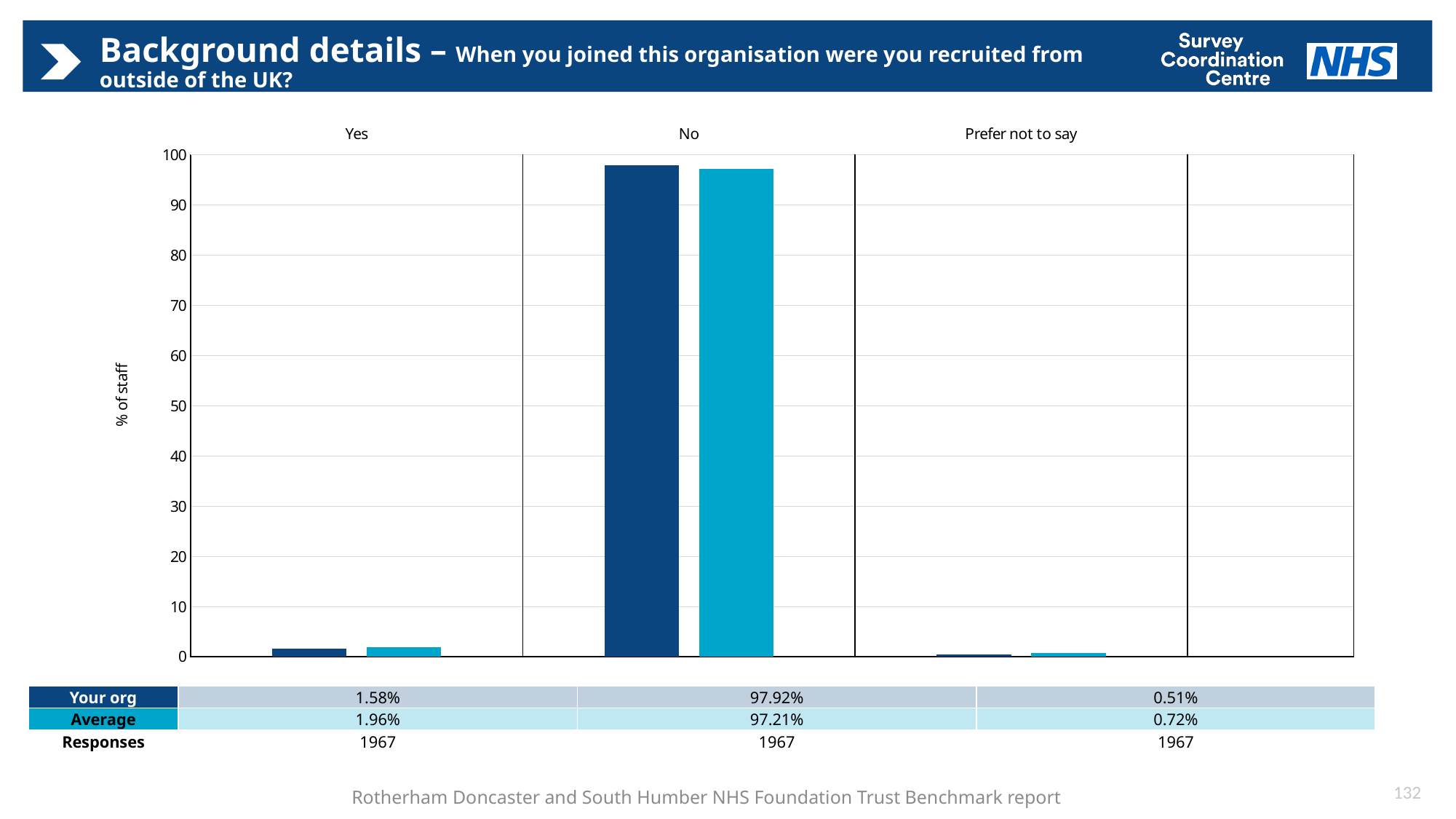
How many response categories are shown on the chart? 3 Is the 'Your org' value for 'No' greater or less than 90? greater For 'Yes', which is larger: the 'Your org' value or the 'Average' value? Average Which category has the lowest 'Average' value? Prefer not to say What is the 'Average' value for 'Prefer not to say'? 0.72% What is the difference between the 'Your org' and 'Average' values for 'No'? 0.71% Which category has the highest 'Your org' value? No What is the 'Your org' value for 'No'? 97.92% What kind of chart is shown on the slide? Bar chart How many series does the chart show? 2 What is the 'Your org' value for 'Prefer not to say'? 0.51% What is the 'Average' value for 'Yes'? 1.96%